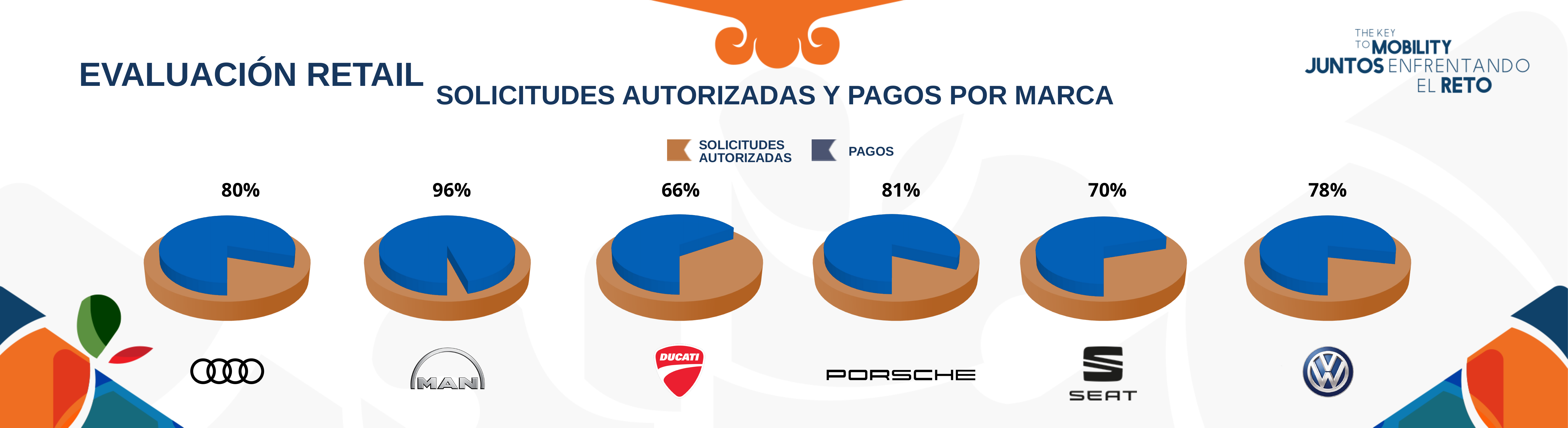
Which has a higher percentage shown, Porsche or SEAT? Porsche What is the difference between the percentage shown for MAN and the percentage shown for Ducati? 30% What percentage is shown above the pie chart for Porsche? 81% How many pie charts are shown on the slide? 6 What percentage is shown above the pie chart for Ducati? 66% Which brand has the highest percentage shown above its pie chart? MAN How many entries does the legend list? 2 What percentage is shown above the pie chart for SEAT? 70% What percentage is shown above the leftmost pie chart (the Audi chart)? 80% What percentage is shown above the pie chart for MAN? 96% What percentage is shown above the pie chart for VW (the rightmost chart)? 78% Which brand has the lowest percentage shown above its pie chart? Ducati